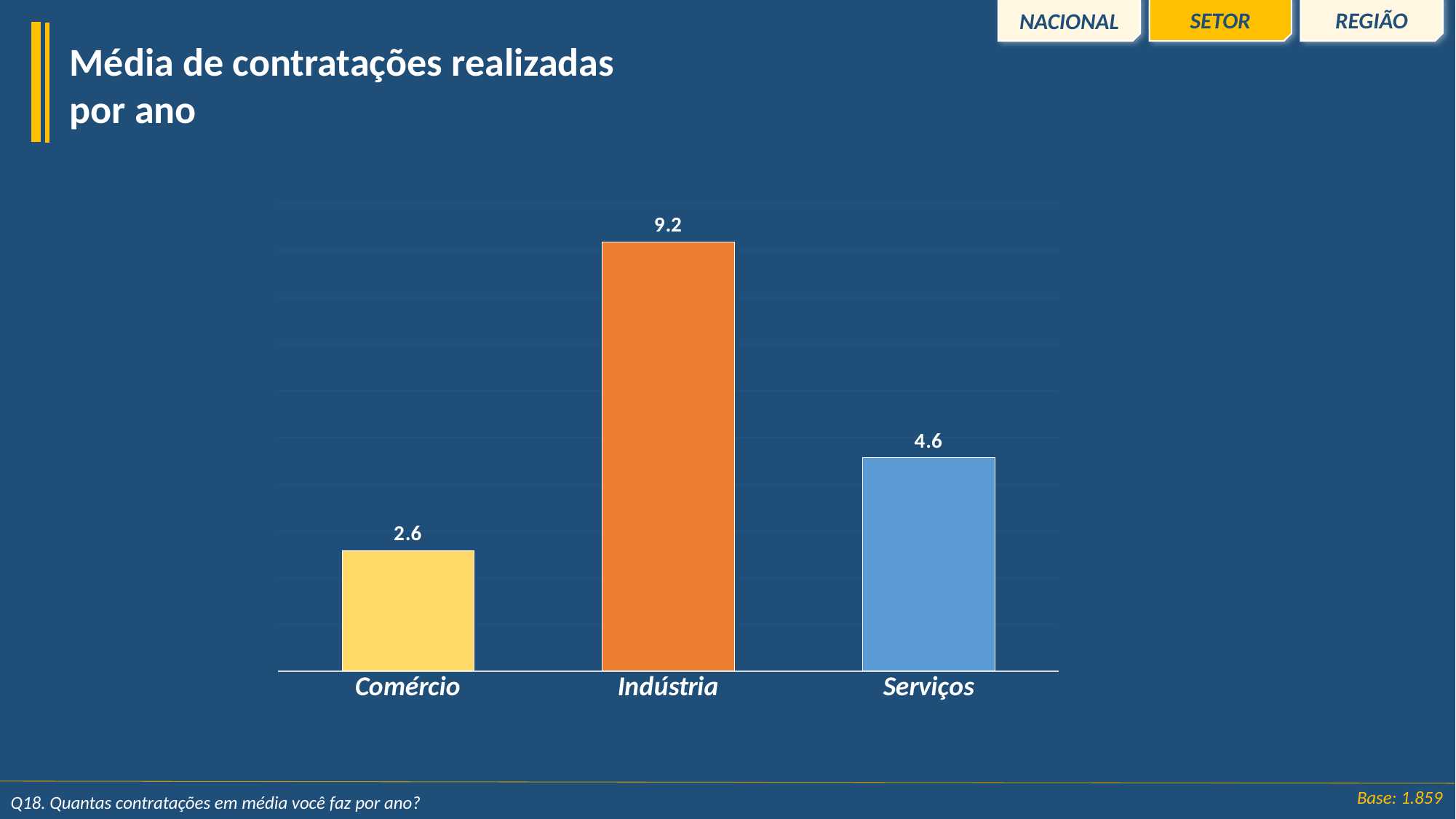
What colour is the bar for Indústria? Orange Which sector has the highest average number of hires per year? Indústria What is the value shown for Serviços? 4.6 What is the title of the chart on the slide? Média de contratações realizadas por ano What is the average number of hires per year for Indústria? 9.2 Which is larger, the value for Serviços or the value for Comércio? Serviços Which sector has the lowest average number of hires per year? Comércio What kind of chart is shown on the slide? Bar chart How many sectors are shown in the chart? 3 What is the difference between the values for Indústria and Serviços? 4.6 What is the value shown for Comércio? 2.6 What is the difference between the values for Serviços and Comércio? 2.0